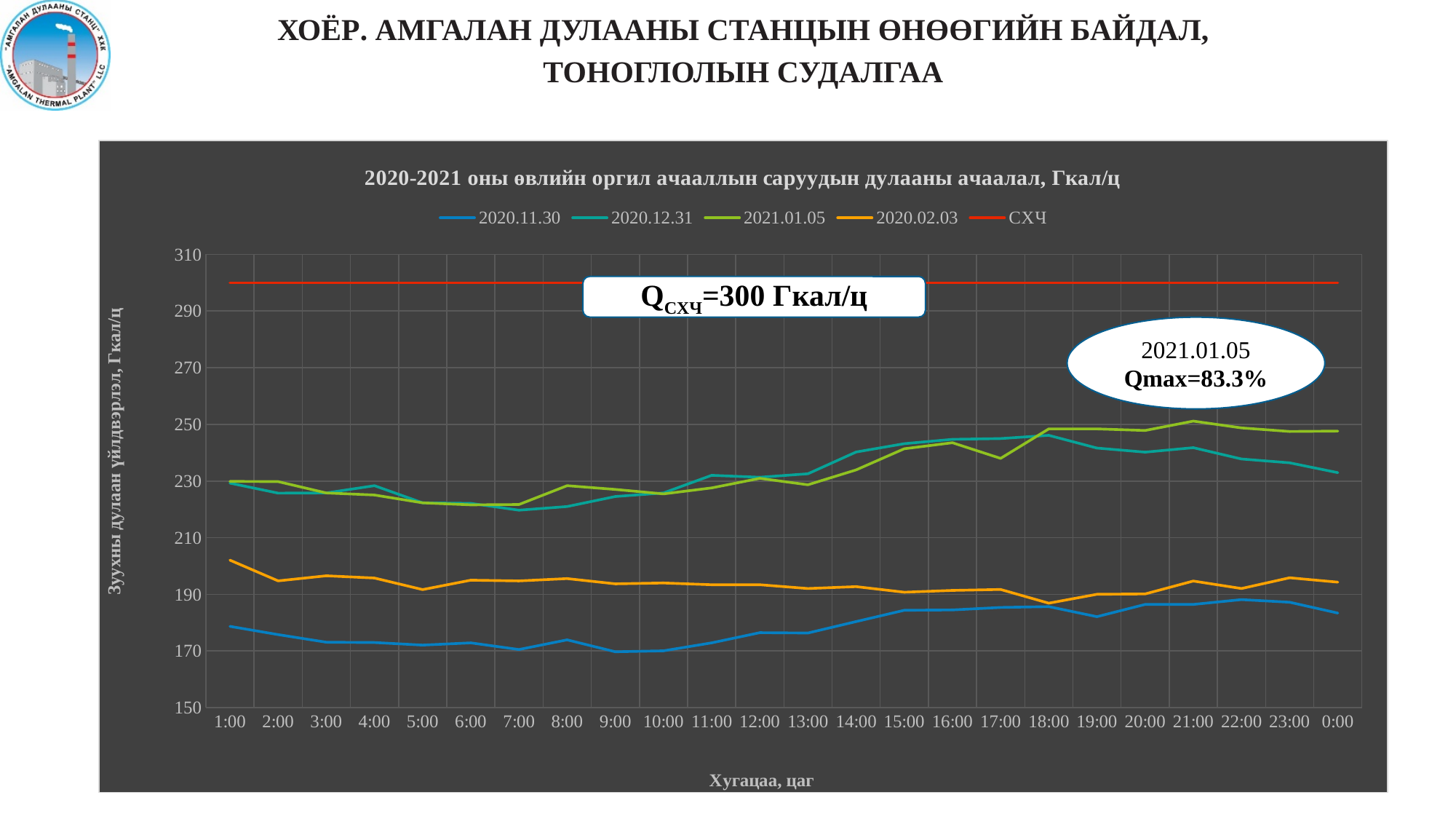
How many time points are shown along the x axis? 24 Which series lies highest on the chart across all hours? СХЧ Does the 2020.12.31 line rise or fall between 10:00 and 16:00? rise How many series does the legend list? 5 Is the value for 2021.01.05 at 7:00 greater or less than 230? less What is the value of the СХЧ line, as stated in the annotation on the chart? 300 Гкал/ц Is the value for 2020.11.30 at 1:00 greater or less than 170? greater Is the value for 2020.12.31 at 18:00 greater or less than 230? greater At 17:00, which is larger: the value for 2020.12.31 or the value for 2021.01.05? 2020.12.31 Which series lies lowest on the chart across all hours? 2020.11.30 What Qmax percentage is given for 2021.01.05 in the oval annotation? 83.3% What kind of chart is shown on the slide? line chart